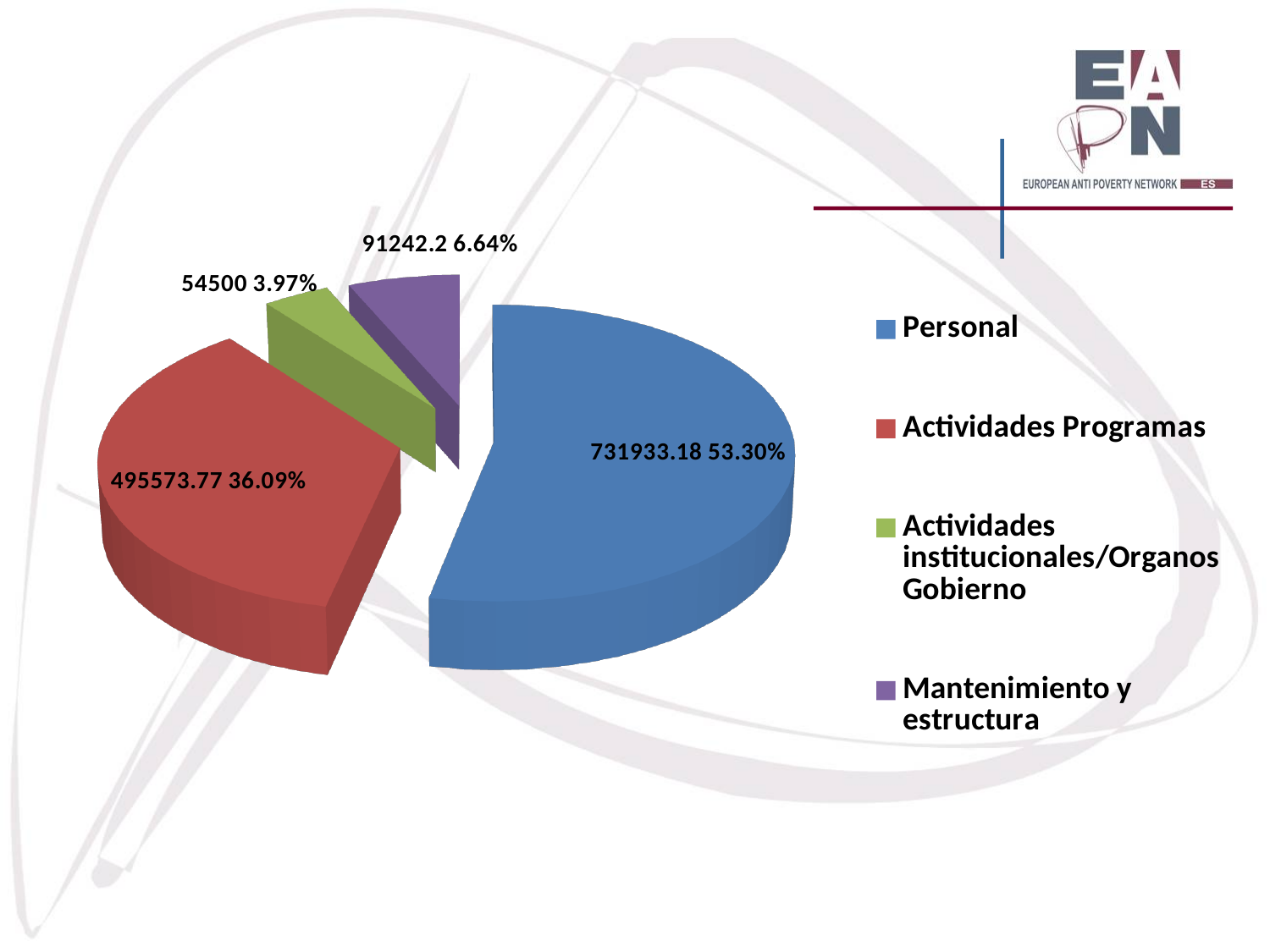
What type of chart is shown on the slide? Pie chart How many slices does the pie chart have? 4 What percentage share does Actividades institucionales/Organos Gobierno have? 3.97% Which is larger, the value for Mantenimiento y estructura or the value for Actividades institucionales/Organos Gobierno? Mantenimiento y estructura What value is shown for the Personal slice? 731933.18 What value is shown for Actividades Programas? 495573.77 Which category has the largest slice of the pie? Personal What colour is the Actividades Programas slice? Red What percentage share does Personal have in the pie chart? 53.30% What value is shown for Mantenimiento y estructura? 91242.2 What is the difference between the values for Personal and Actividades Programas? 236359.41 Which category has the smallest slice of the pie? Actividades institucionales/Organos Gobierno